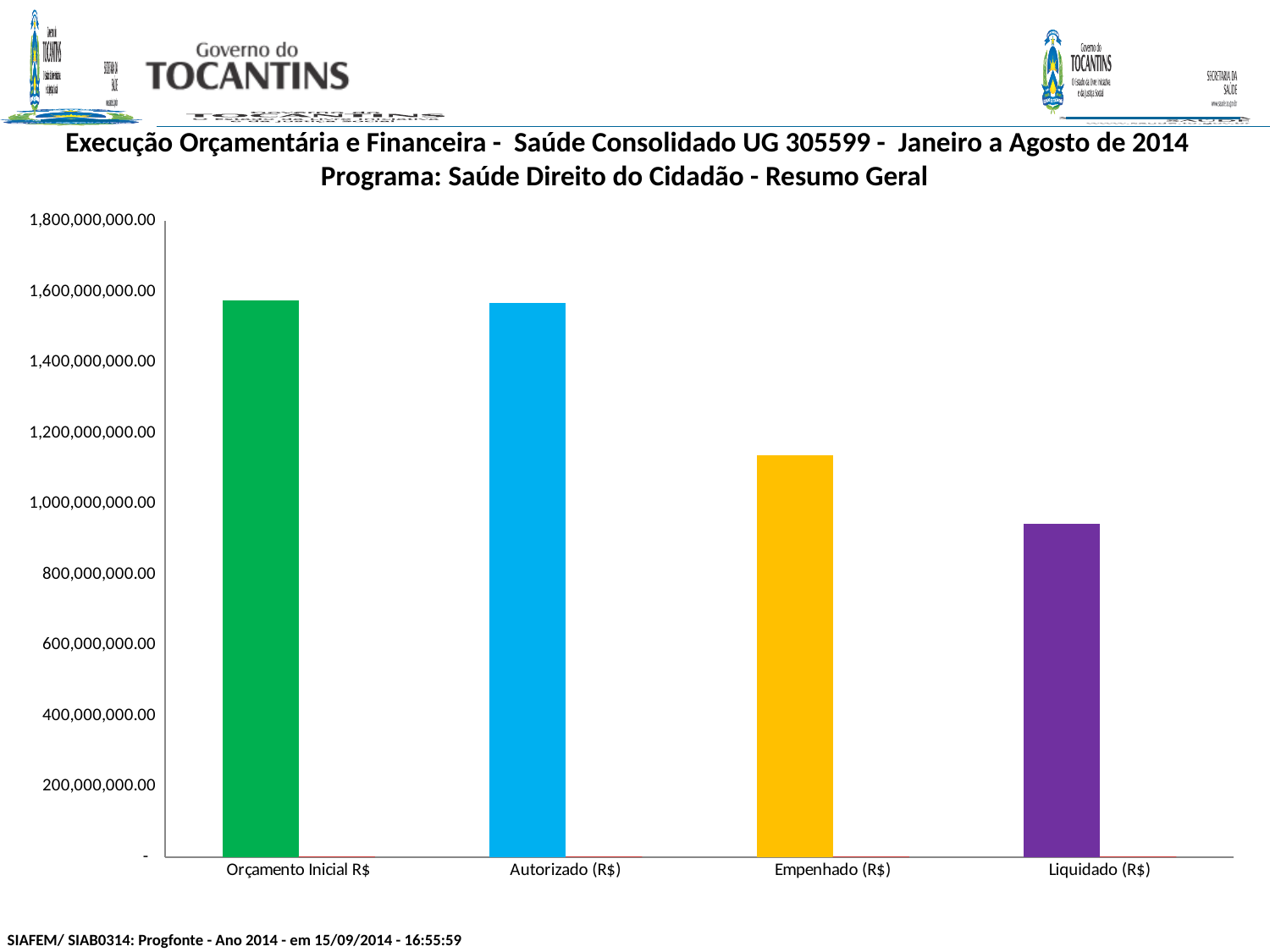
Which is larger, the value for Orçamento Inicial R$ or the value for Empenhado (R$)? Orçamento Inicial R$ Which category has the lowest value in the chart? Liquidado (R$) Is the value for Empenhado (R$) greater or less than 1,000,000,000.00? greater Is the value for Empenhado (R$) greater or less than 1,200,000,000.00? less Is the value for Autorizado (R$) greater or less than 1,400,000,000.00? greater What colour is the bar for Liquidado (R$)? purple Do the bar values rise or fall from left to right along the x axis? fall Which is larger, the value for Empenhado (R$) or the value for Liquidado (R$)? Empenhado (R$) How many categories are plotted on the x axis of the chart? 4 What kind of chart is shown on the slide? bar chart